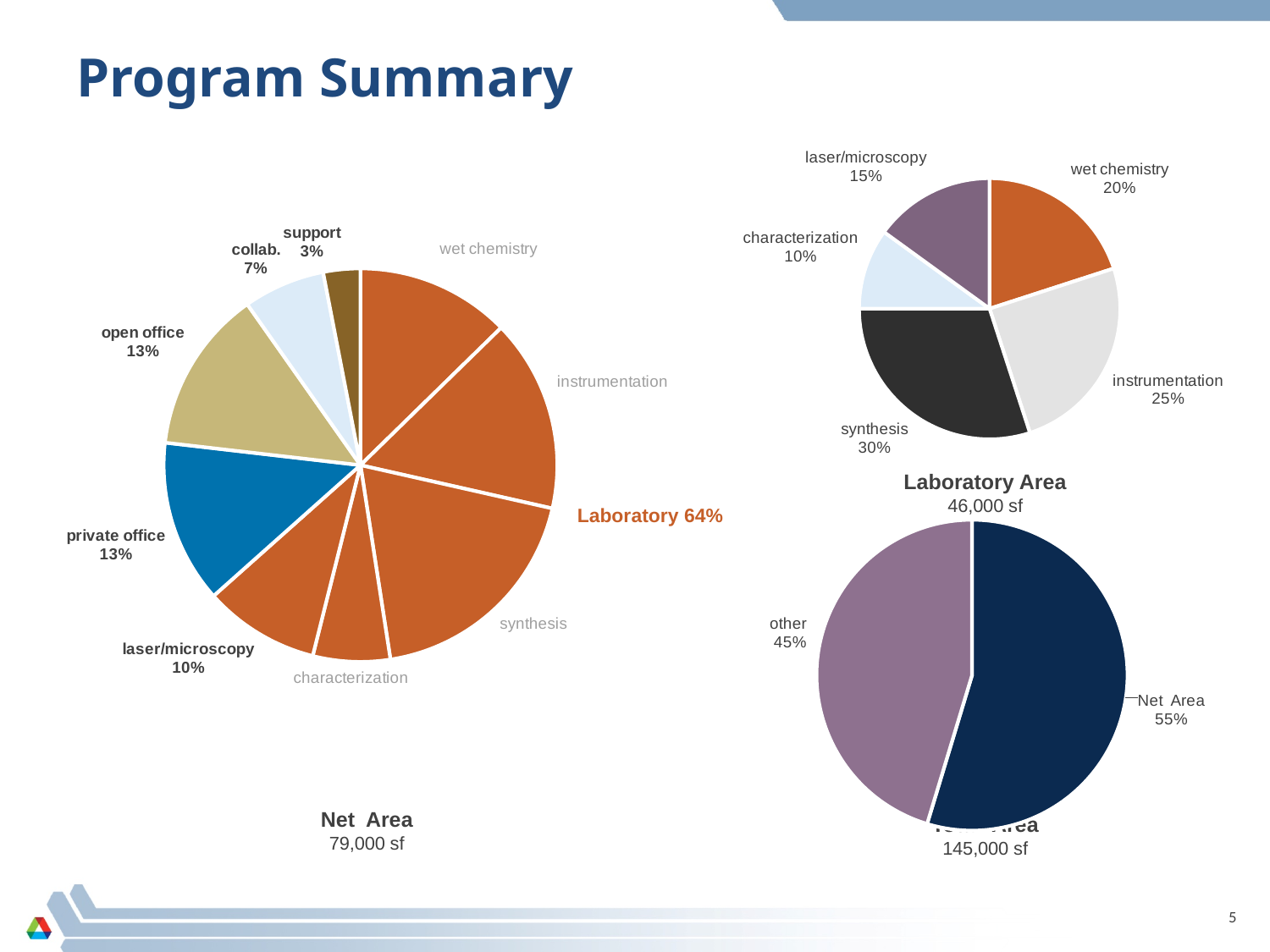
In the Net Area chart, what share is labelled Laboratory? 64% In the Net Area chart, what percentage is private office? 13% What type of chart is the Net Area chart? pie chart How many slices does the Laboratory Area pie chart have? 5 In the Net Area chart, which is larger, open office or collab.? open office In the pie chart at the bottom right of the slide, what percentage is Net Area? 55% In the Laboratory Area chart, what percentage is synthesis? 30% In the Laboratory Area chart, which category has the largest share? synthesis In the Laboratory Area chart, what is the difference between the instrumentation and wet chemistry percentages? 5% In the pie chart at the bottom right of the slide, which slice is larger, Net Area or other? Net Area In the Laboratory Area chart, which category has the smallest share? characterization In the Net Area chart, what percentage is support? 3%